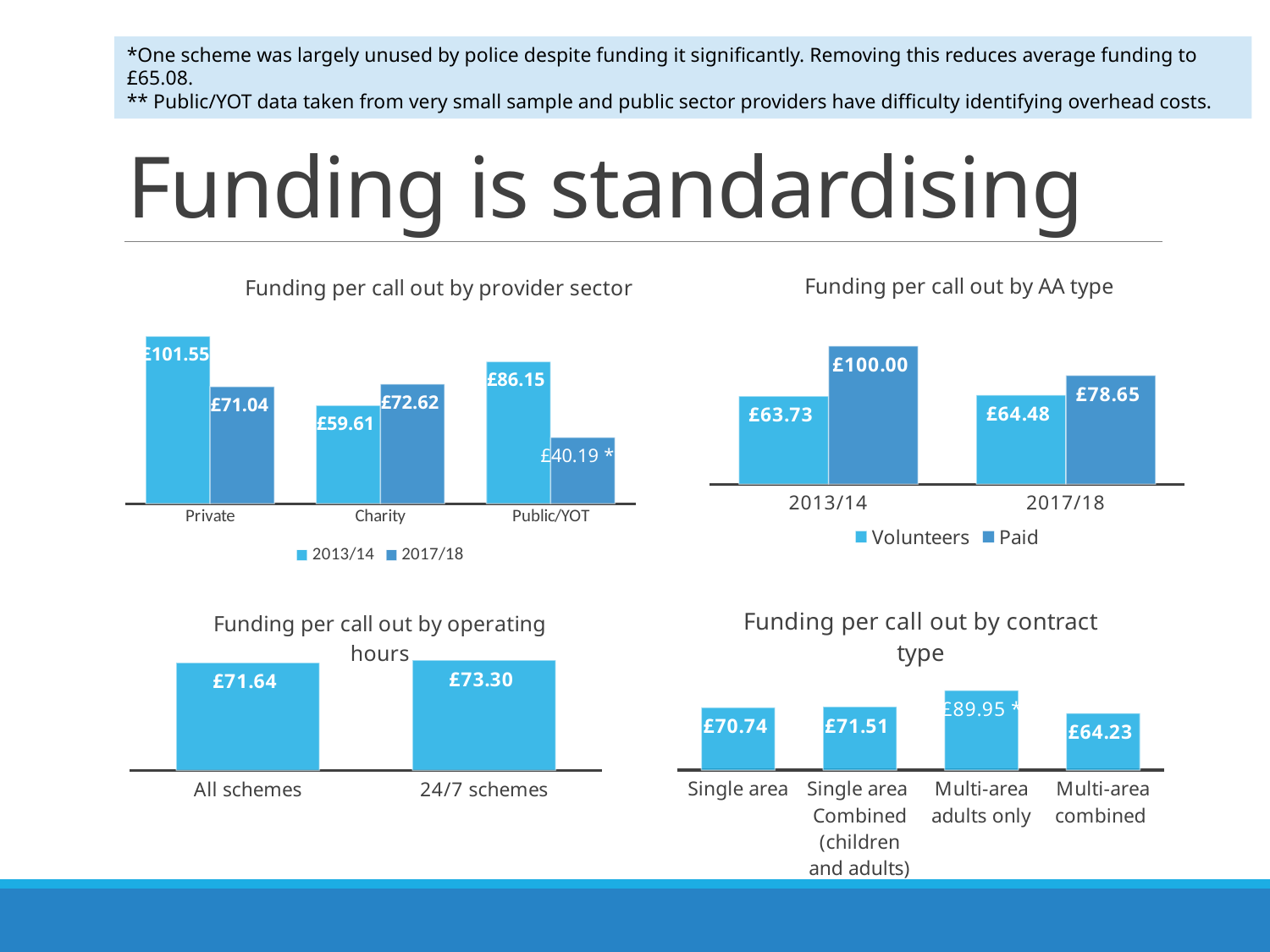
In the 'Funding per call out by provider sector' chart, what is the difference between the 2013/14 and 2017/18 values for Private? £30.51 In the 'Funding per call out by AA type' chart, what is the Paid value for 2013/14? £100.00 In the 'Funding per call out by provider sector' chart, how many series does the legend list? 2 In the 'Funding per call out by provider sector' chart, what is the 2013/14 value for Private? £101.55 In the 'Funding per call out by contract type' chart, how many contract types are shown? 4 In the 'Funding per call out by provider sector' chart, which sector has the lowest 2017/18 value? Public/YOT In the 'Funding per call out by operating hours' chart, what is the value for All schemes? £71.64 In the 'Funding per call out by contract type' chart, which contract type has the lowest value? Multi-area combined In the 'Funding per call out by AA type' chart, does the Paid value rise or fall from 2013/14 to 2017/18? fall In the 'Funding per call out by provider sector' chart, what is the 2017/18 value for Charity? £72.62 In the 'Funding per call out by operating hours' chart, which is larger: All schemes or 24/7 schemes? 24/7 schemes In the 'Funding per call out by AA type' chart, what is the Volunteers value for 2017/18? £64.48